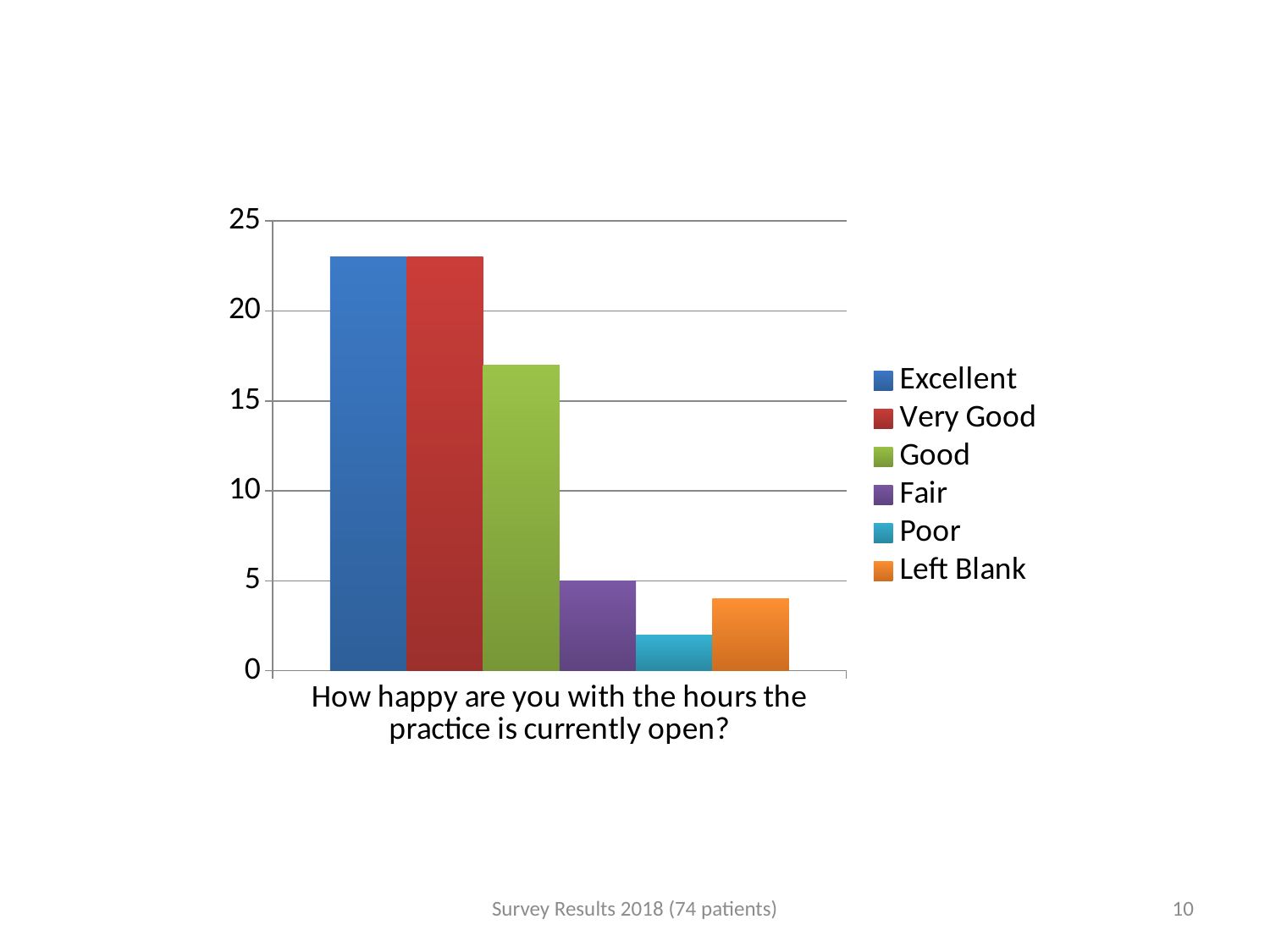
Which is larger, the value for Good or the value for Fair? Good Which response category has the lowest value? Poor Is the value for Good greater or less than 15? greater Which is larger, the value for Left Blank or the value for Poor? Left Blank Is the value for Excellent greater or less than 20? greater How many series does the legend list? 6 What kind of chart is shown on the slide? bar chart Is the value for Left Blank greater or less than 5? less What question is shown as the category label on the x axis? How happy are you with the hours the practice is currently open? Which legend entry is shown in orange? Left Blank